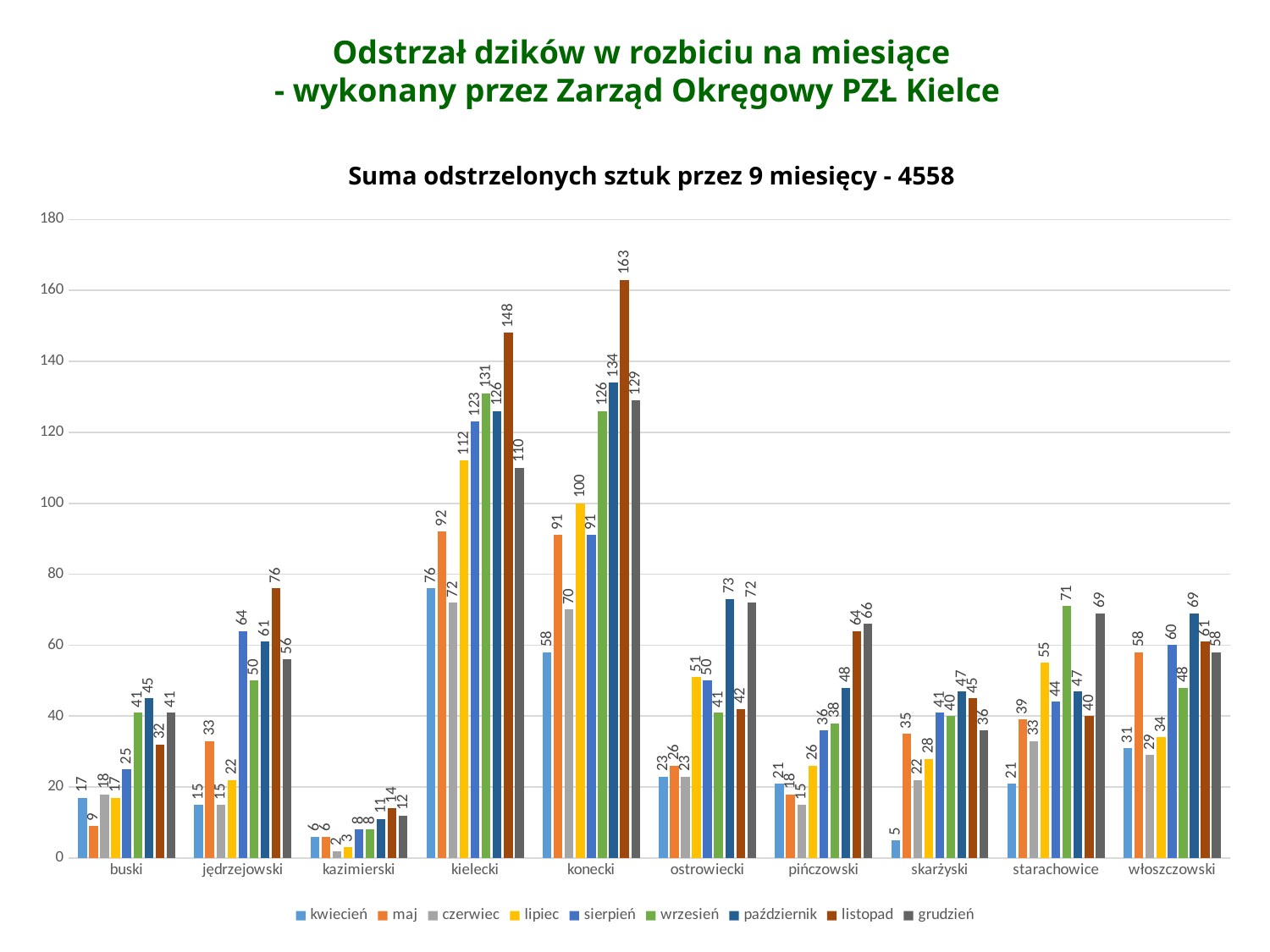
Is the value for lipiec in kielecki greater or less than 100? greater How many series does the legend list? 9 Which category has the highest value for listopad? konecki What total number of animals shot over 9 months is stated in the chart subtitle? 4558 What kind of chart is shown? bar chart How many categories are shown on the x axis? 10 Which is larger: the wrzesień value for starachowice or the wrzesień value for włoszczowski? starachowice What is the value for listopad in konecki? 163 What is the difference between the listopad values for kielecki and konecki? 15 Which category has the lowest value for kwiecień? skarżyski What is the value for kwiecień in kielecki? 76 What is the value for grudzień in ostrowiecki? 72